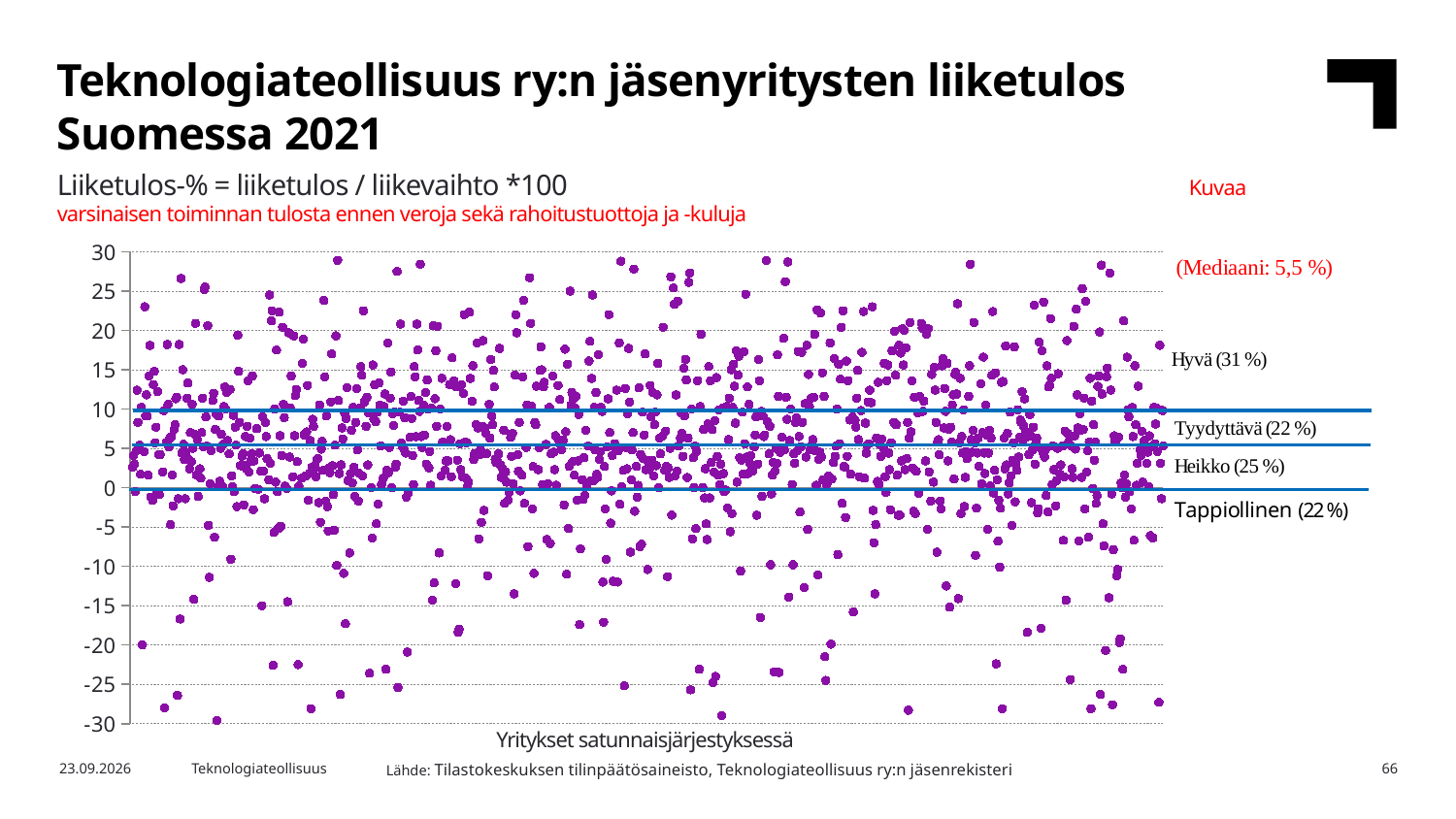
What is the label of the horizontal axis of the chart? Yritykset satunnaisjärjestyksessä Which group has the larger share of companies, Heikko or Tyydyttävä? Heikko What is the median operating profit percentage (Mediaani) shown on the chart? 5,5 % What share of companies is labelled as Hyvä on the chart? 31 % What share of companies is labelled as Tappiollinen on the chart? 22 % What share of companies is labelled as Heikko on the chart? 25 % At which vertical-axis values are the three horizontal reference lines drawn on the chart? 10, 5 and 0 Which of the four labelled groups (Hyvä, Tyydyttävä, Heikko, Tappiollinen) has the largest share of companies? Hyvä What share of companies is labelled as Tyydyttävä on the chart? 22 % What kind of chart is shown on the slide? Scatter chart What is the difference in percentage points between the share of Hyvä companies and the share of Tappiollinen companies? 9 percentage points What is the highest value shown on the vertical axis of the chart? 30